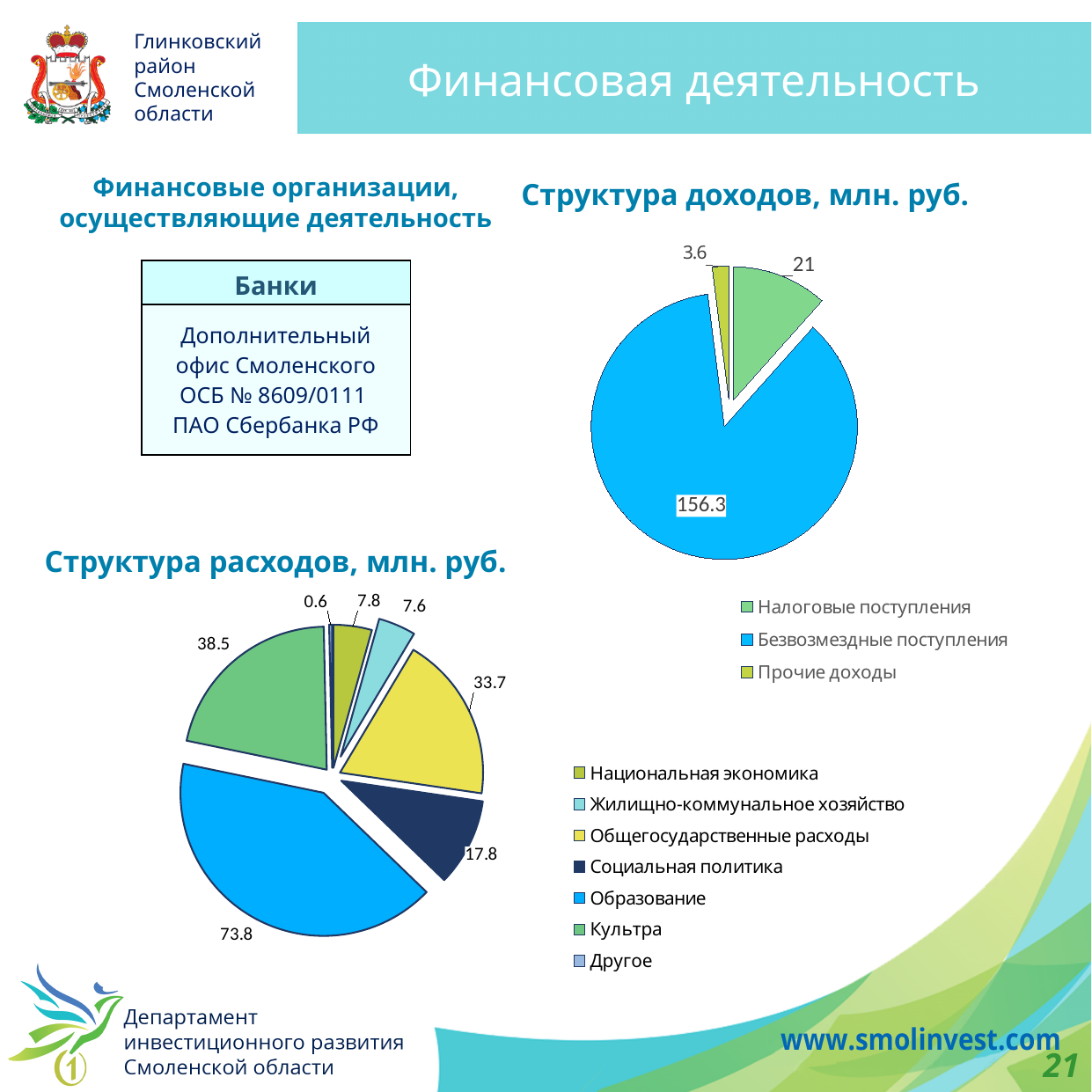
In the 'Структура доходов, млн. руб.' chart, which category has the smallest value? Прочие доходы In the 'Структура расходов, млн. руб.' chart, what is the difference between Культура and Общегосударственные расходы? 4.8 In the 'Структура расходов, млн. руб.' chart, what is the value for Образование? 73.8 In the 'Структура расходов, млн. руб.' chart, how many categories does the legend list? 7 In the 'Структура доходов, млн. руб.' chart, what is the value for Налоговые поступления? 21 In the 'Структура доходов, млн. руб.' chart, what is the difference between Безвозмездные поступления and Налоговые поступления? 135.3 In the 'Структура доходов, млн. руб.' chart, how many categories does the legend list? 3 In the 'Структура расходов, млн. руб.' chart, what is the value for Социальная политика? 17.8 What kind of chart is 'Структура расходов, млн. руб.'? Pie chart In the 'Структура расходов, млн. руб.' chart, which is larger: Культура or Общегосударственные расходы? Культура In the 'Структура расходов, млн. руб.' chart, which category has the largest value? Образование In the 'Структура доходов, млн. руб.' chart, what is the value for Безвозмездные поступления? 156.3